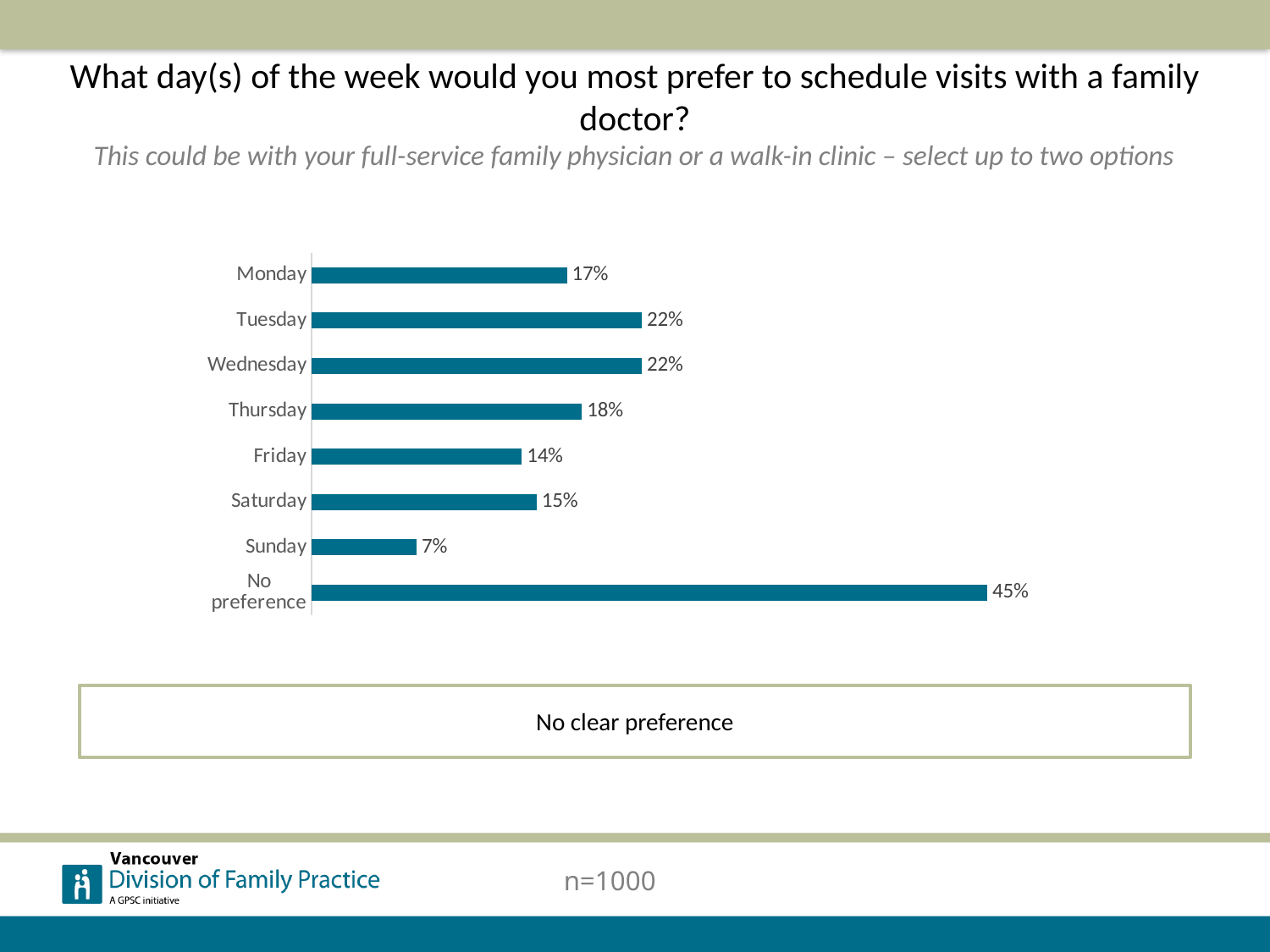
What is the difference between the 'No preference' value and the Monday value? 28% What percentage of respondents selected 'No preference'? 45% What is the difference between the values for Tuesday and Friday? 8% What is the value shown for Sunday? 7% Which category has the highest value in the chart? No preference What percentage of respondents preferred Monday? 17% What is the value shown for Wednesday? 22% Which day of the week has the lowest value? Sunday Which has a larger value, Thursday or Saturday? Thursday What kind of chart is shown on the slide? Bar chart What sample size is stated on the slide? n=1000 How many categories are shown in the chart? 8